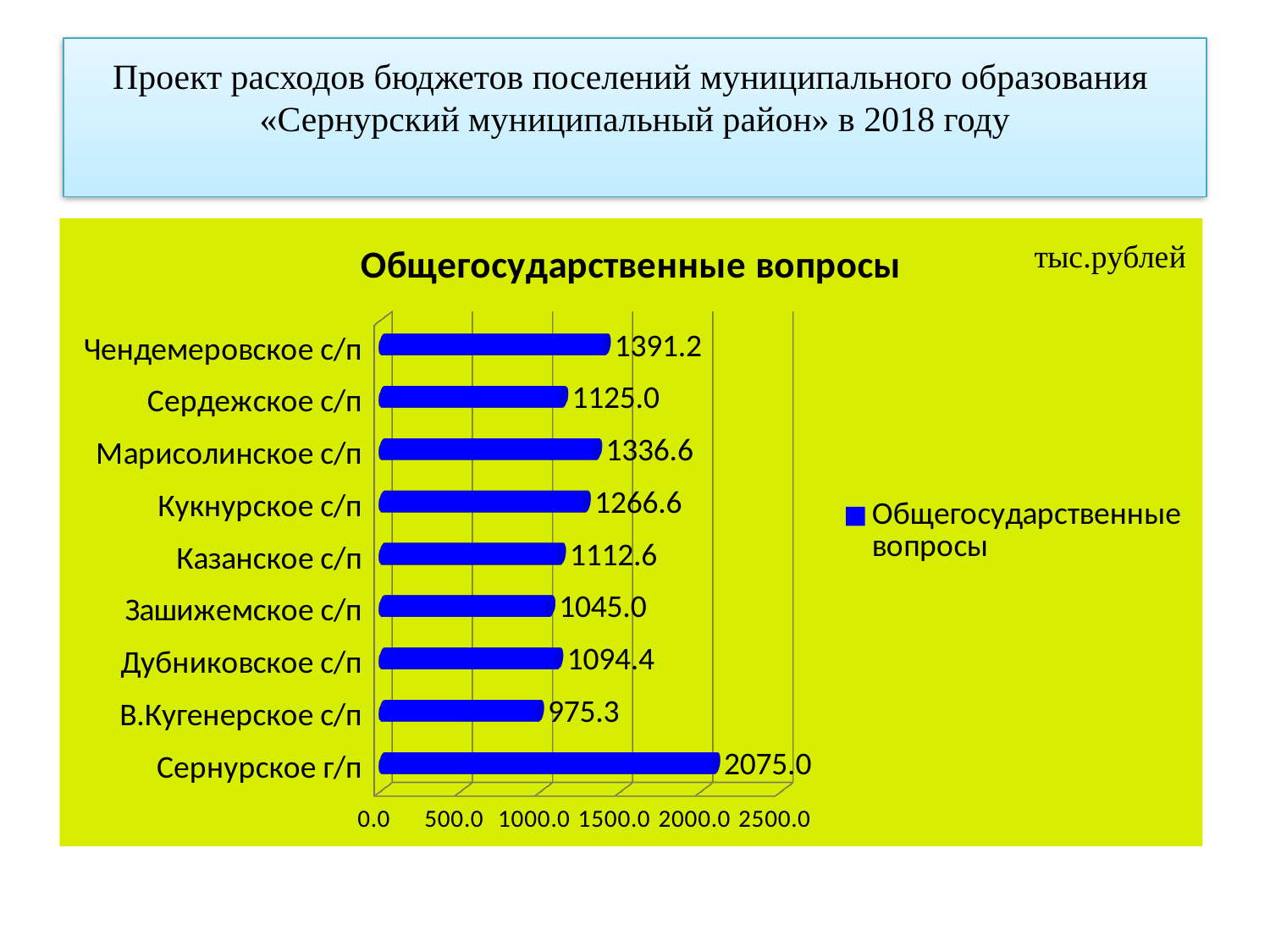
What is the value for Зашижемское с/п? 1045.0 What kind of chart is shown on the slide? bar chart What is the value for Чендемеровское с/п? 1391.2 Which category has the lowest value? В.Кугенерское с/п What is the title of the chart? Общегосударственные вопросы What is the value for Сернурское г/п? 2075.0 How many categories are shown on the chart? 9 How many series does the legend list? 1 Which category has the highest value? Сернурское г/п Is the value for Сердежское с/п greater or less than 1000.0? greater What is the difference between the values for Сернурское г/п and В.Кугенерское с/п? 1099.7